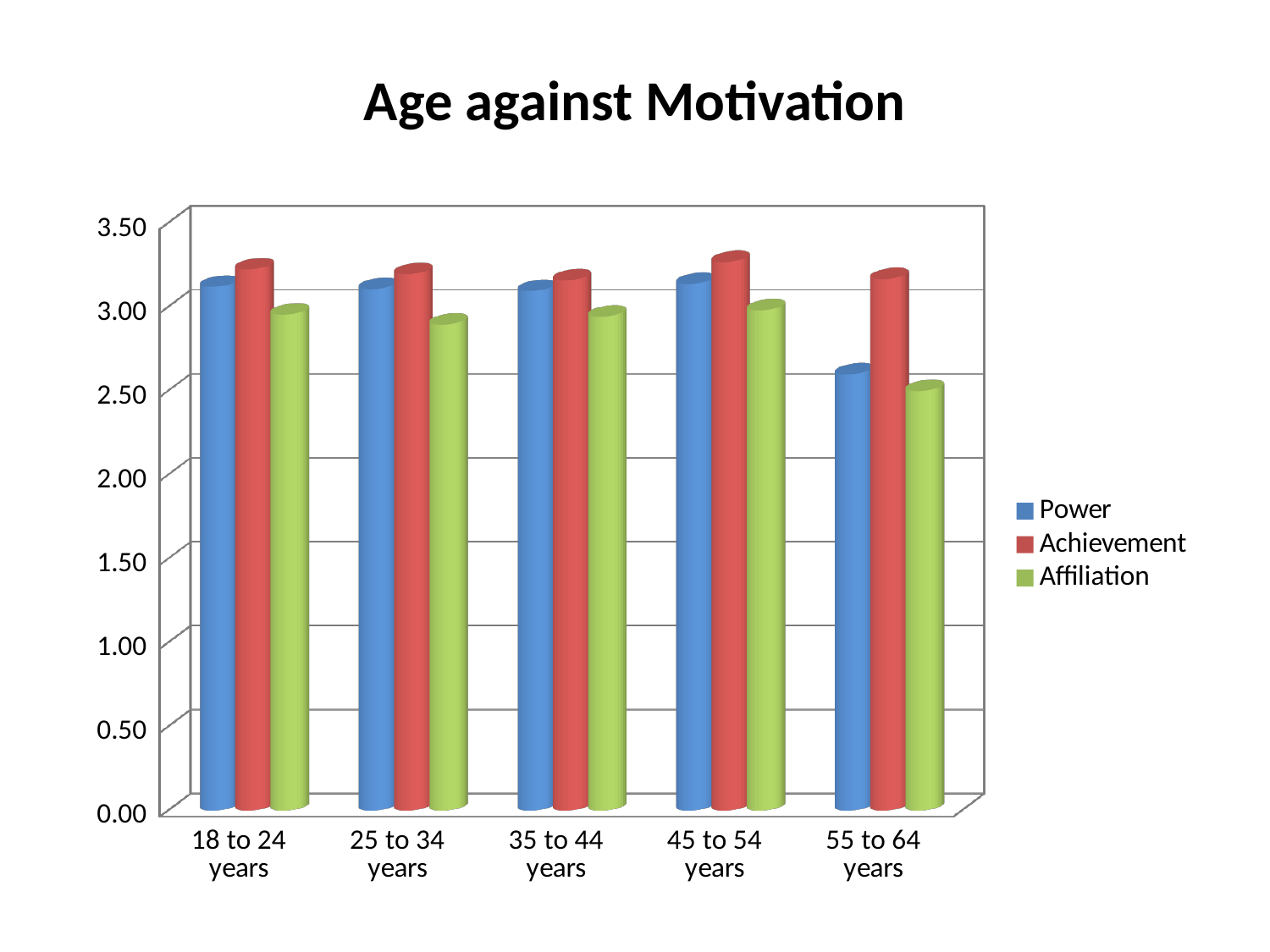
Is the Achievement value for 55 to 64 years greater or less than 3.00? greater Which age group has the lowest Power value? 55 to 64 years Which age group has the lowest Affiliation value? 55 to 64 years How many series does the legend list? 3 Which is larger, the Power value for 45 to 54 years or the Power value for 55 to 64 years? 45 to 54 years Which series is shown in green in the legend? Affiliation What is the title of the chart? Age against Motivation What kind of chart is shown on the slide? Bar chart How many age groups are shown on the x axis? 5 For the 55 to 64 years group, which series has the highest value? Achievement Is the Power value for 55 to 64 years greater or less than 3.00? less Is the Affiliation value for 55 to 64 years greater or less than 2.00? greater